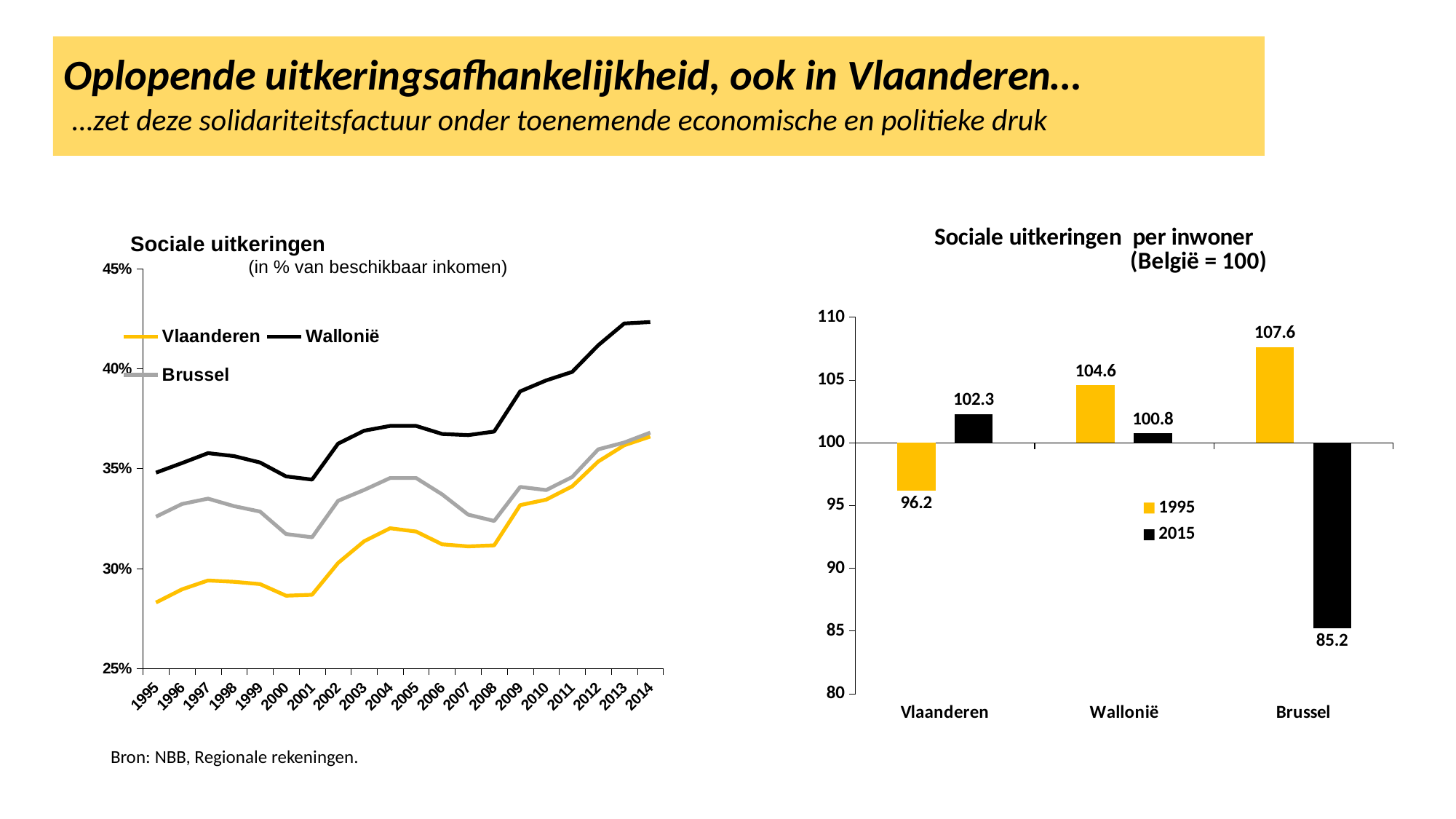
In the 'Sociale uitkeringen per inwoner' bar chart, how many series does the legend list? 2 In the 'Sociale uitkeringen (in % van beschikbaar inkomen)' line chart, does the Vlaanderen series overall rise or fall from 1995 to 2014? Rise In the 'Sociale uitkeringen per inwoner' bar chart, which region has the lowest value in 2015? Brussel What kind of chart is the 'Sociale uitkeringen (in % van beschikbaar inkomen)' chart on the left? Line chart In the 'Sociale uitkeringen (in % van beschikbaar inkomen)' line chart, how many series does the legend list? 3 In the 'Sociale uitkeringen (in % van beschikbaar inkomen)' line chart, is the value for Wallonië in 2014 greater or less than 40%? greater In the 'Sociale uitkeringen per inwoner' bar chart, what is the value for Vlaanderen in 1995? 96.2 In the 'Sociale uitkeringen per inwoner' bar chart, which region has the highest value in 1995? Brussel In the 'Sociale uitkeringen per inwoner' bar chart, what is the difference between the 1995 and 2015 values for Brussel? 22.4 In the 'Sociale uitkeringen per inwoner' bar chart, which is larger for Vlaanderen: the 1995 value or the 2015 value? 2015 In the 'Sociale uitkeringen per inwoner' bar chart, what is the value for Brussel in 2015? 85.2 In the 'Sociale uitkeringen per inwoner' bar chart, what is the value for Wallonië in 2015? 100.8